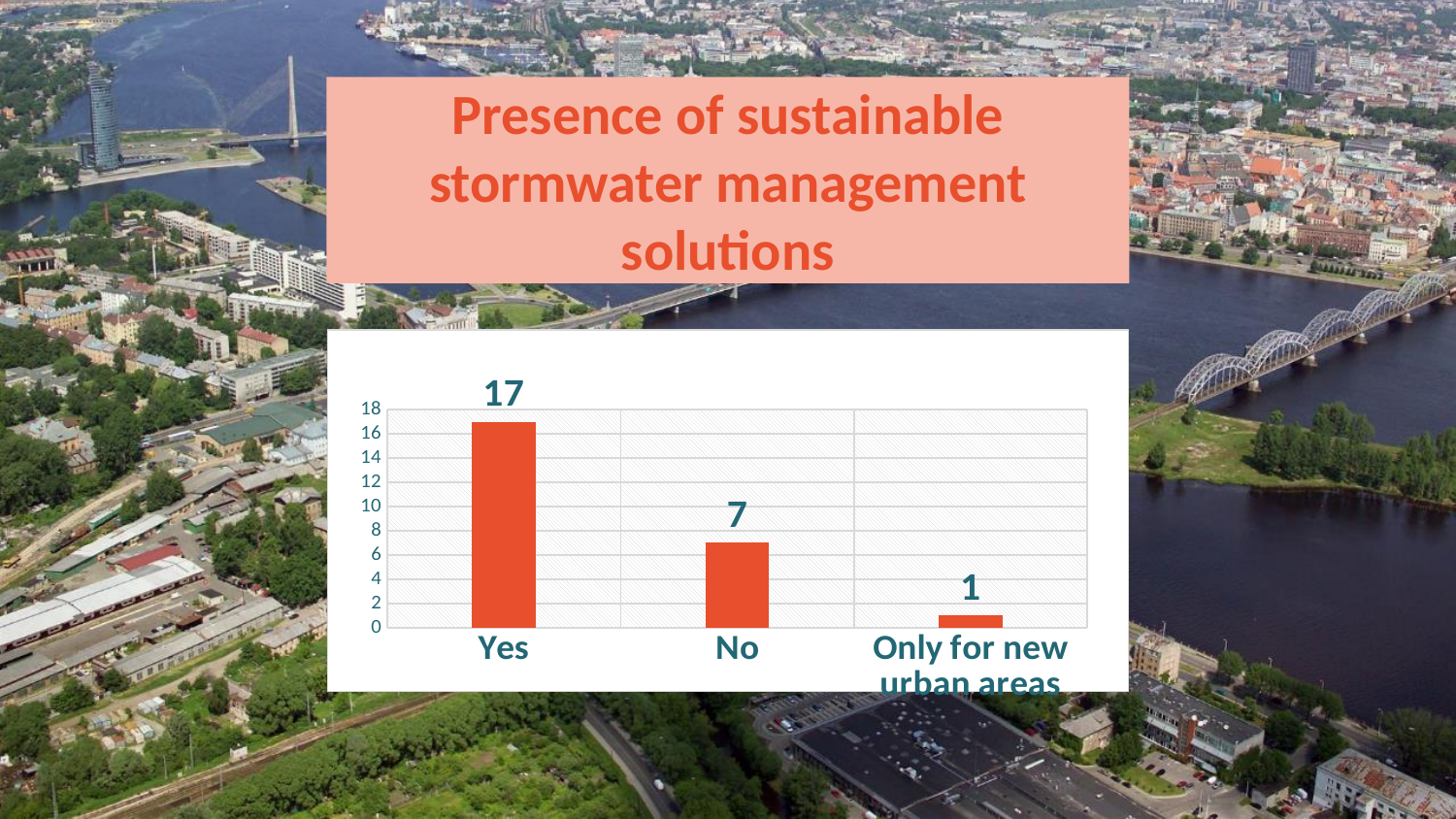
How many categories are shown on the x axis? 3 Which category has the highest value? Yes What is the difference between the values for "No" and "Only for new urban areas"? 6 What is the value for "No"? 7 Is the value for "Yes" greater or less than 10? greater What is the value for "Only for new urban areas"? 1 What kind of chart is shown on the slide? bar chart Which category has the lowest value? Only for new urban areas What is the difference between the values for "Yes" and "No"? 10 Which is larger, the value for "No" or the value for "Only for new urban areas"? No What is the value for "Yes"? 17 What is the title shown above the chart? Presence of sustainable stormwater management solutions